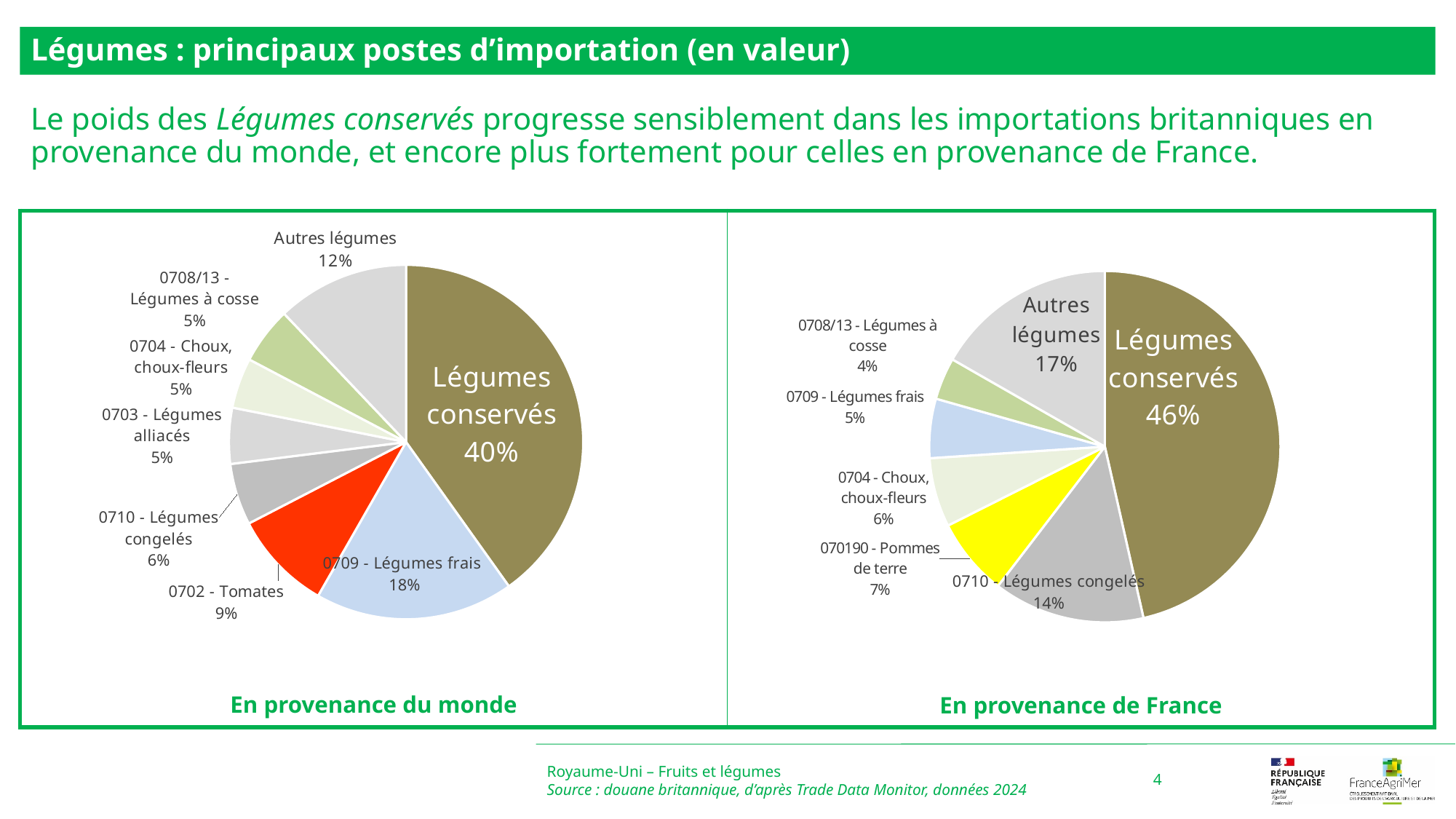
In the 'En provenance de France' pie chart, which is larger: the share of 0710 - Légumes congelés or the share of 0704 - Choux, choux-fleurs? 0710 - Légumes congelés In the 'En provenance du monde' pie chart, what is the share of 0709 - Légumes frais? 18% How many slices does the 'En provenance du monde' pie chart have? 8 What type of chart is used on this slide? Pie chart In the 'En provenance de France' pie chart, what is the share of 0710 - Légumes congelés? 14% In the 'En provenance de France' pie chart, what share do Légumes conservés represent? 46% In the 'En provenance du monde' pie chart, what share do Légumes conservés represent? 40% In the 'En provenance de France' pie chart, what is the share of 070190 - Pommes de terre? 7% In the 'En provenance du monde' pie chart, what is the difference between the shares of Légumes conservés and 0709 - Légumes frais? 22 percentage points In the 'En provenance du monde' pie chart, which category has the largest share? Légumes conservés In the 'En provenance de France' pie chart, which category has the smallest share? 0708/13 - Légumes à cosse How many slices does the 'En provenance de France' pie chart have? 7